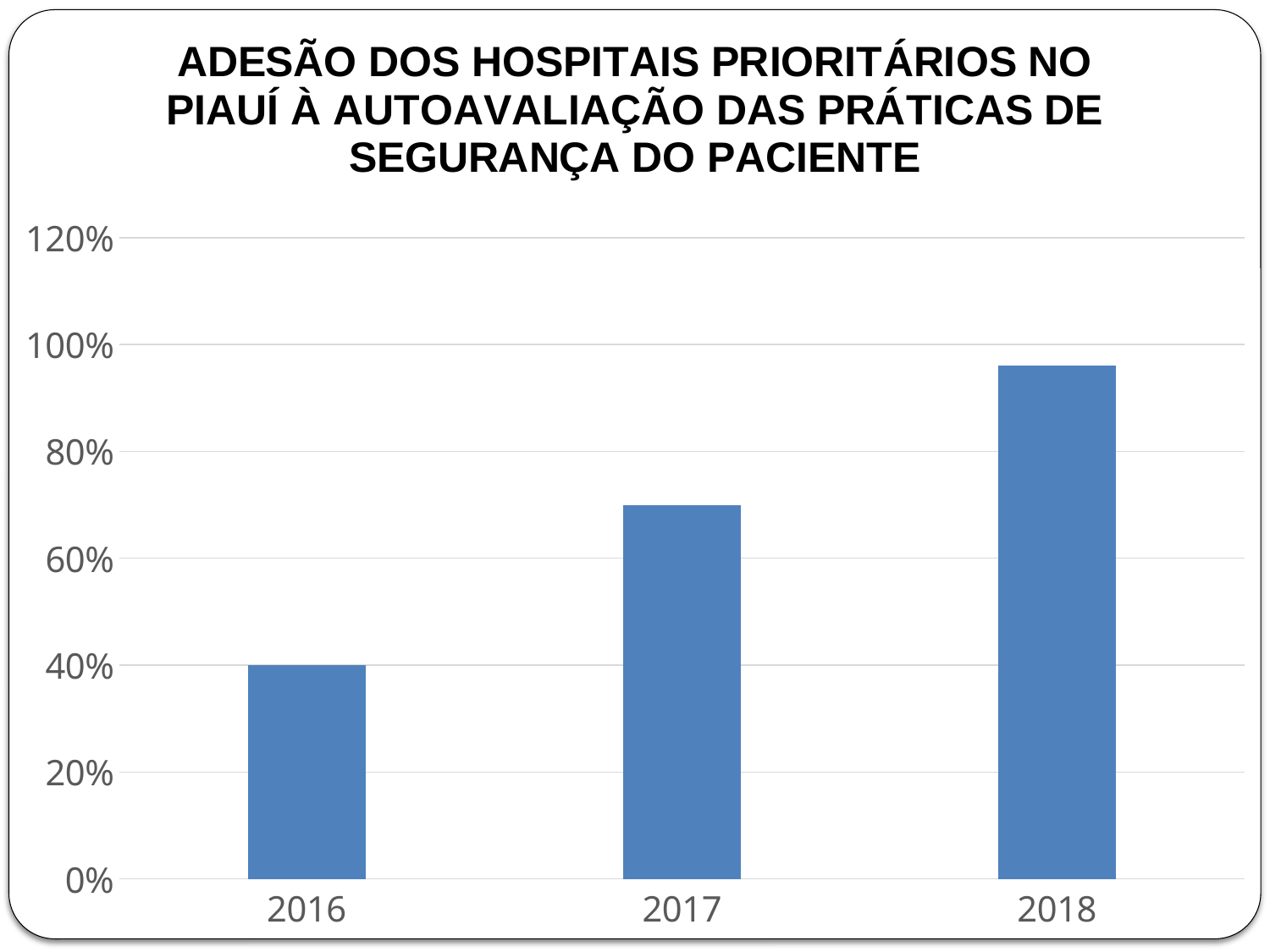
What type of chart is shown on the slide? bar chart Is the value for 2017 greater or less than 80%? less Which year has the highest value? 2018 Is the value for 2018 greater or less than 80%? greater Is the value for 2018 greater or less than 100%? less What is the highest value shown on the y axis? 120% Which is larger, the value for 2017 or the value for 2016? 2017 Which year has the lowest value? 2016 How many years are shown on the x axis of the chart? 3 Do the values rise or fall from 2016 to 2018? rise What is the value for 2016? 40%